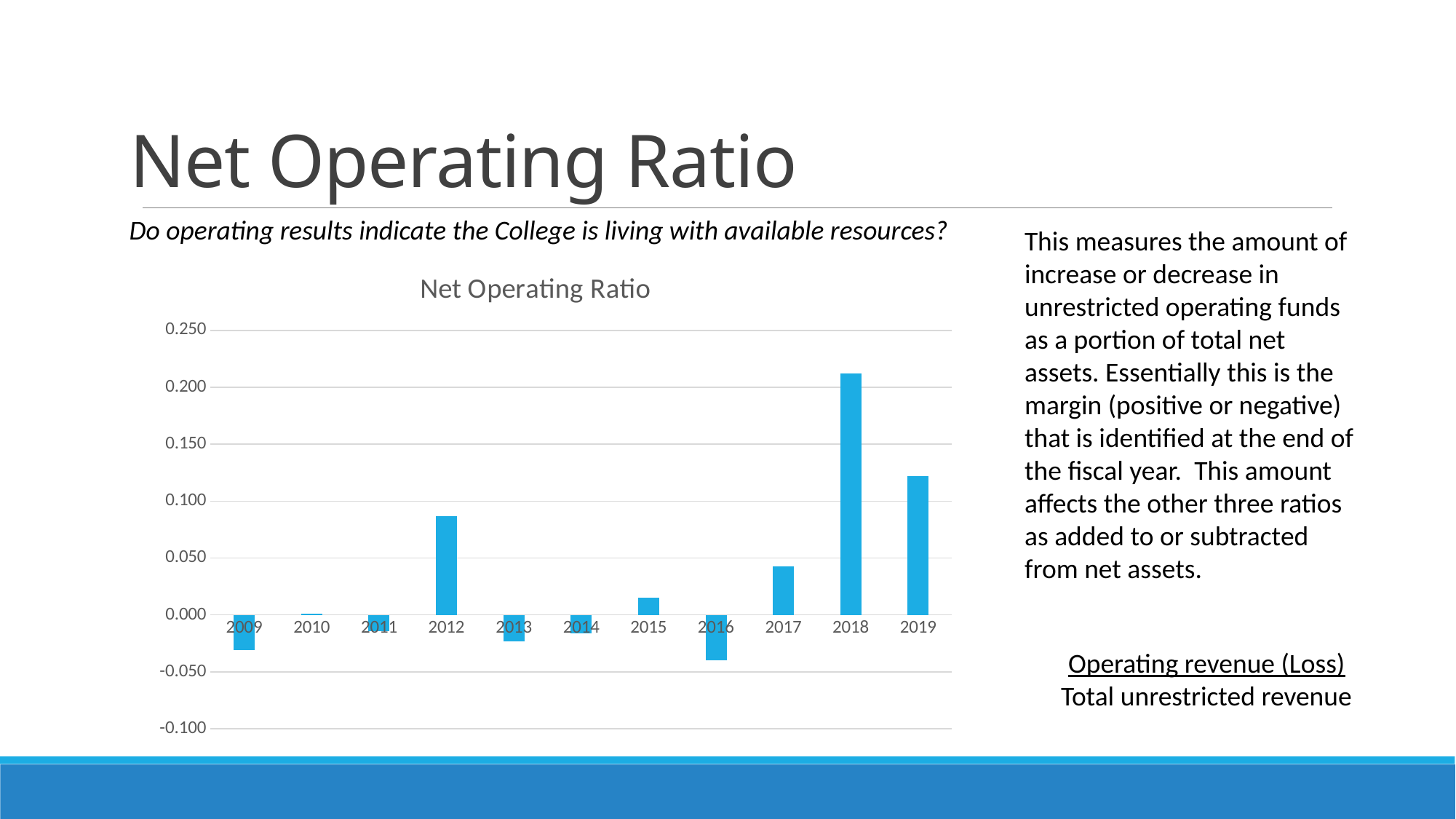
How many years are plotted on the x axis of the chart? 11 Which year has the highest net operating ratio? 2018 Is the value for 2019 greater or less than 0.100? greater What kind of chart is shown on the slide? bar chart Is the value for 2018 greater or less than 0.200? greater Which year has the lowest net operating ratio? 2016 Which year has the larger net operating ratio, 2018 or 2019? 2018 Is the value for 2012 greater or less than 0.100? less How many years show a negative net operating ratio? 5 Which year has the larger net operating ratio, 2012 or 2017? 2012 What is the title of the chart? Net Operating Ratio